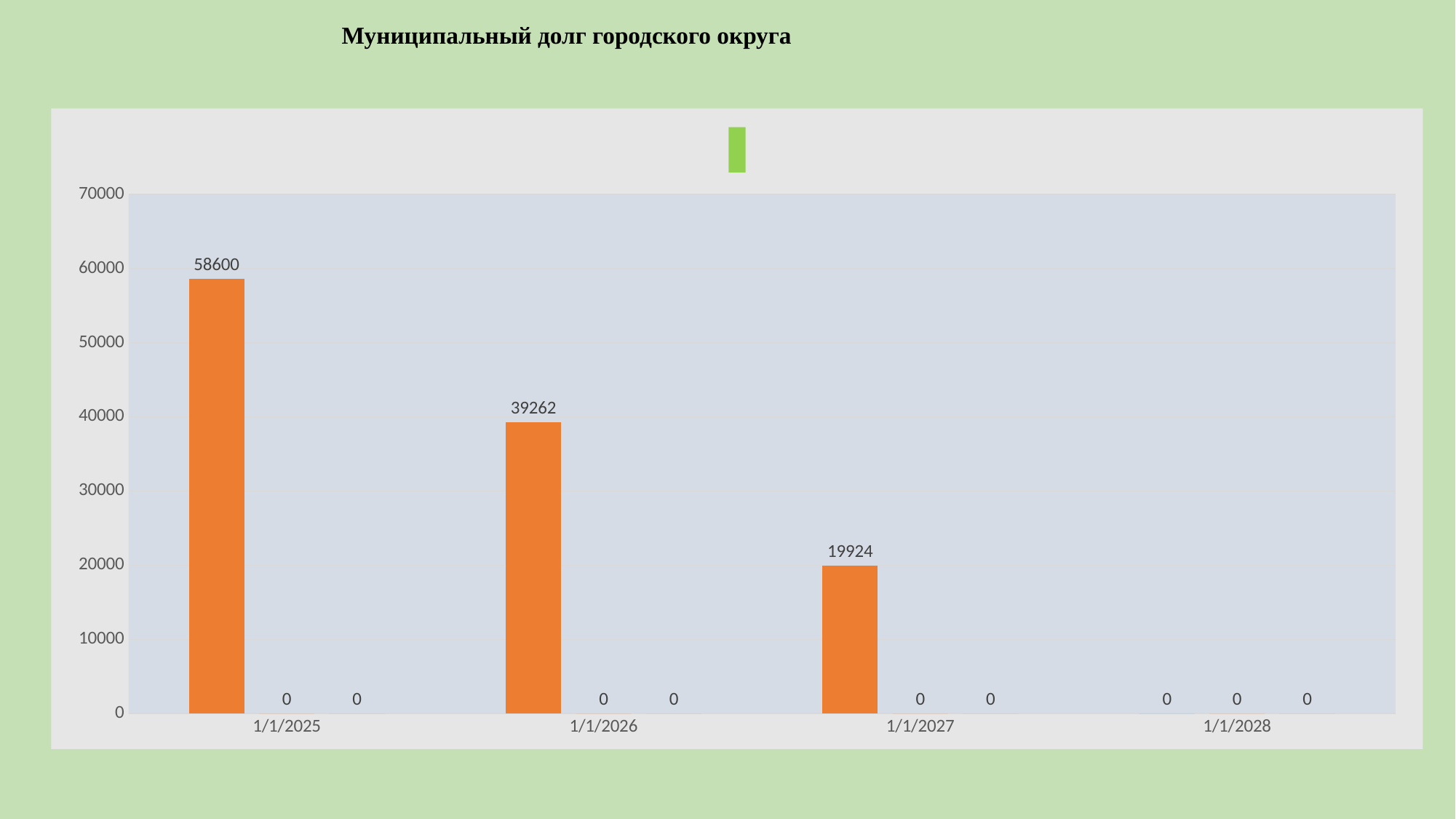
What is the difference between the orange bar values for 1/1/2025 and 1/1/2026? 19338 What is the value of the orange bar for 1/1/2027? 19924 What is the value of the orange bar for 1/1/2025? 58600 Is the value for 1/1/2026 greater or less than 40000? less How many dates are shown on the x axis? 4 What kind of chart is shown on the slide? bar chart What is the value of the orange bar for 1/1/2026? 39262 What is the difference between the orange bar values for 1/1/2025 and 1/1/2027? 38676 Which date has the highest value on the chart? 1/1/2025 Which is larger, the orange bar for 1/1/2026 or for 1/1/2027? 1/1/2026 Which date has the lowest value for the orange series? 1/1/2028 What value is labelled for 1/1/2028? 0